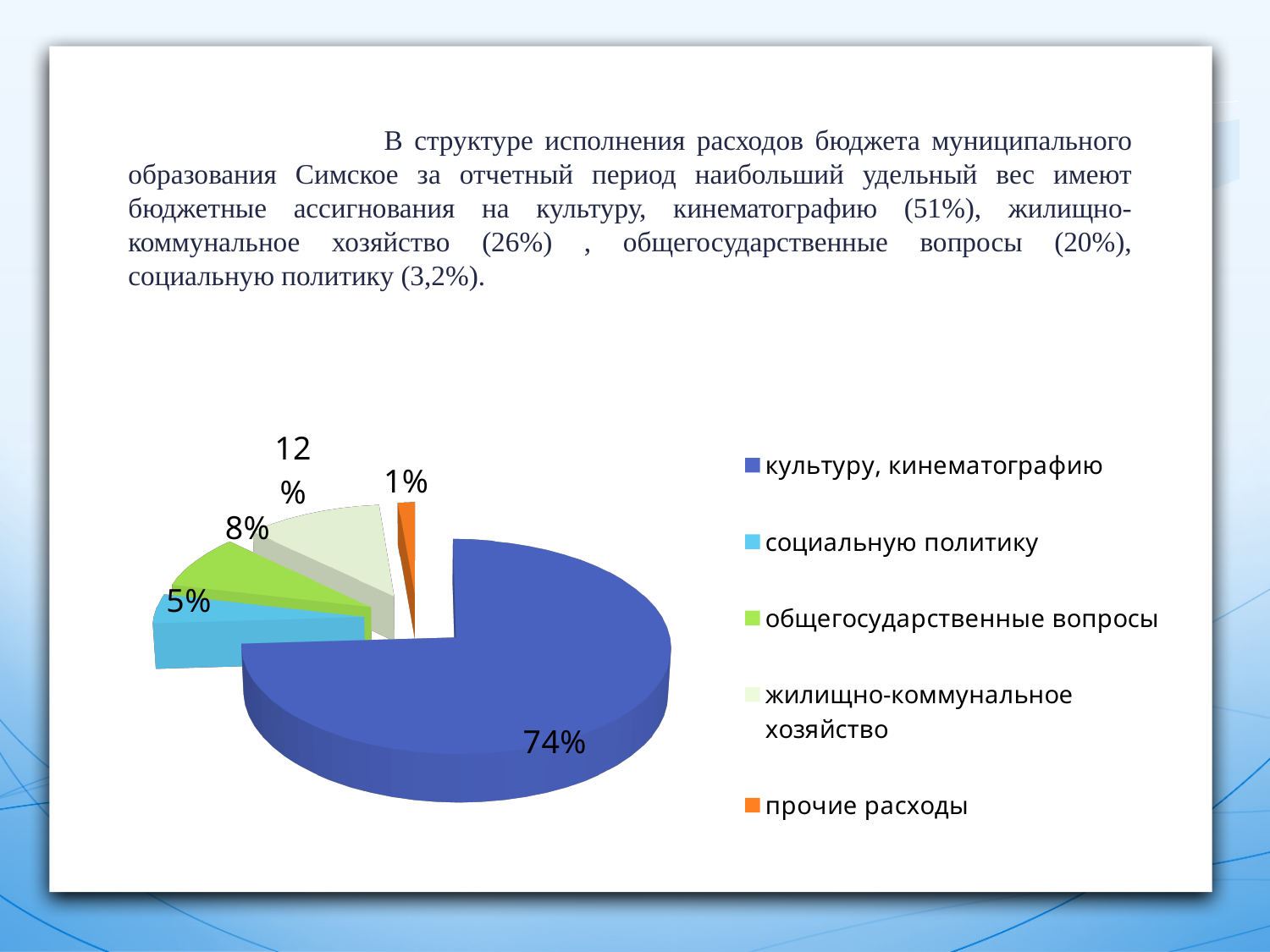
What share of the pie does жилищно-коммунальное хозяйство have? 12% What share of the pie does прочие расходы have? 1% Which category has the smallest slice of the pie? прочие расходы What kind of chart is shown on the slide? pie chart How many slices does the pie chart have? 5 Which slice is larger: общегосударственные вопросы or социальную политику? общегосударственные вопросы What colour is the slice for прочие расходы? orange Which category has the largest slice of the pie? культуру, кинематографию What share of the pie does культуру, кинематографию have? 74% What is the difference in percentage points between the slices for культуру, кинематографию and жилищно-коммунальное хозяйство? 62